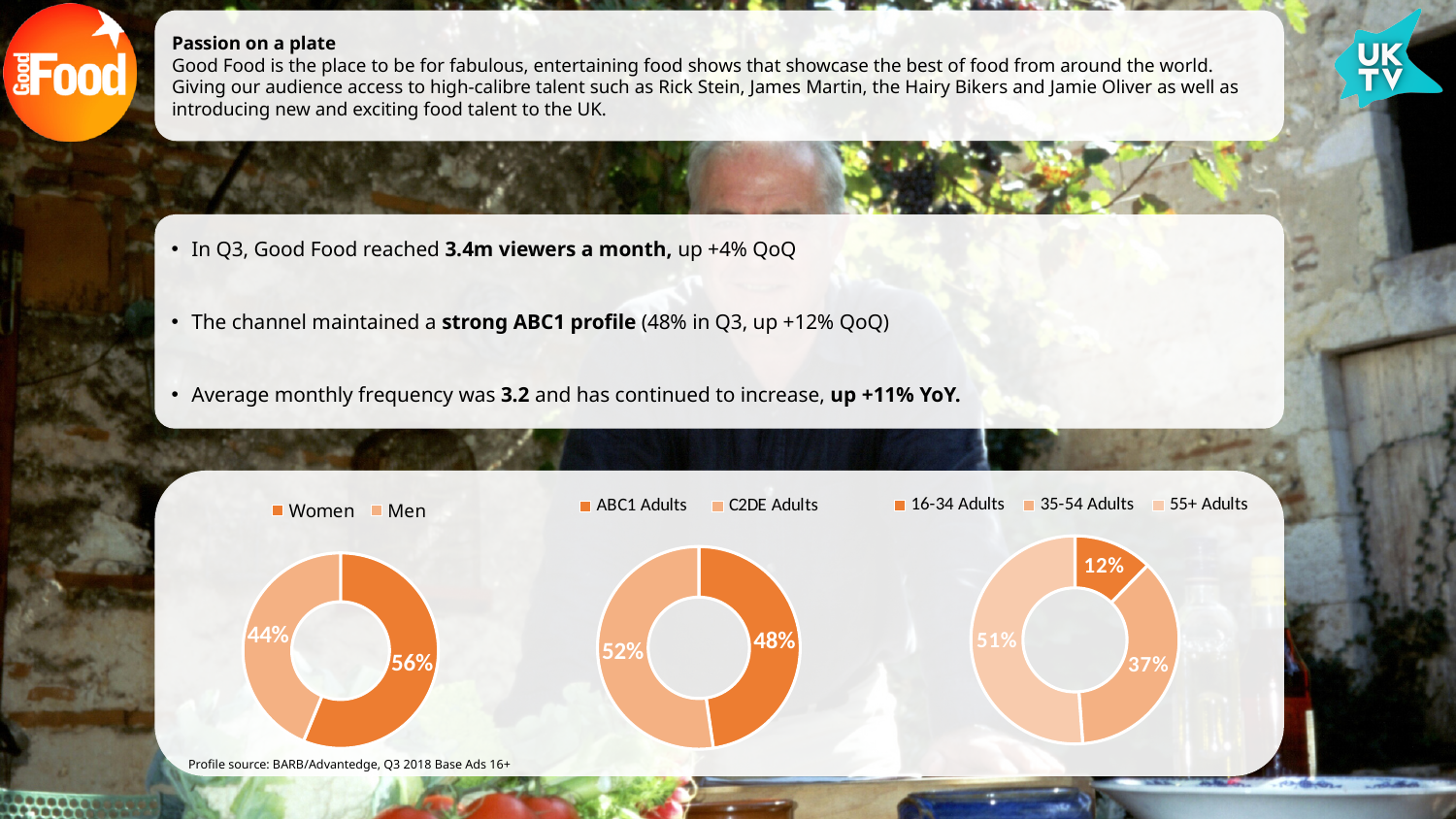
What kind of chart is used for the three charts at the bottom of the slide? Donut (pie) chart In the right donut chart (age groups), which age group has the smallest share? 16-34 Adults In the right donut chart (age groups), what share is 16-34 Adults? 12% In the right donut chart (age groups), which age group has the largest share? 55+ Adults In the left donut chart (Women/Men), what share is Men? 44% In the middle donut chart (ABC1/C2DE Adults), what share is C2DE Adults? 52% In the right donut chart (age groups), what share is 55+ Adults? 51% In the left donut chart (Women/Men), what is the difference between the Women and Men shares? 12% In the middle donut chart, which is larger, ABC1 Adults or C2DE Adults? C2DE Adults In the left donut chart (Women/Men), what share is Women? 56% In the middle donut chart (ABC1/C2DE Adults), what share is ABC1 Adults? 48% How many series does the legend of the right donut chart (age groups) list? 3